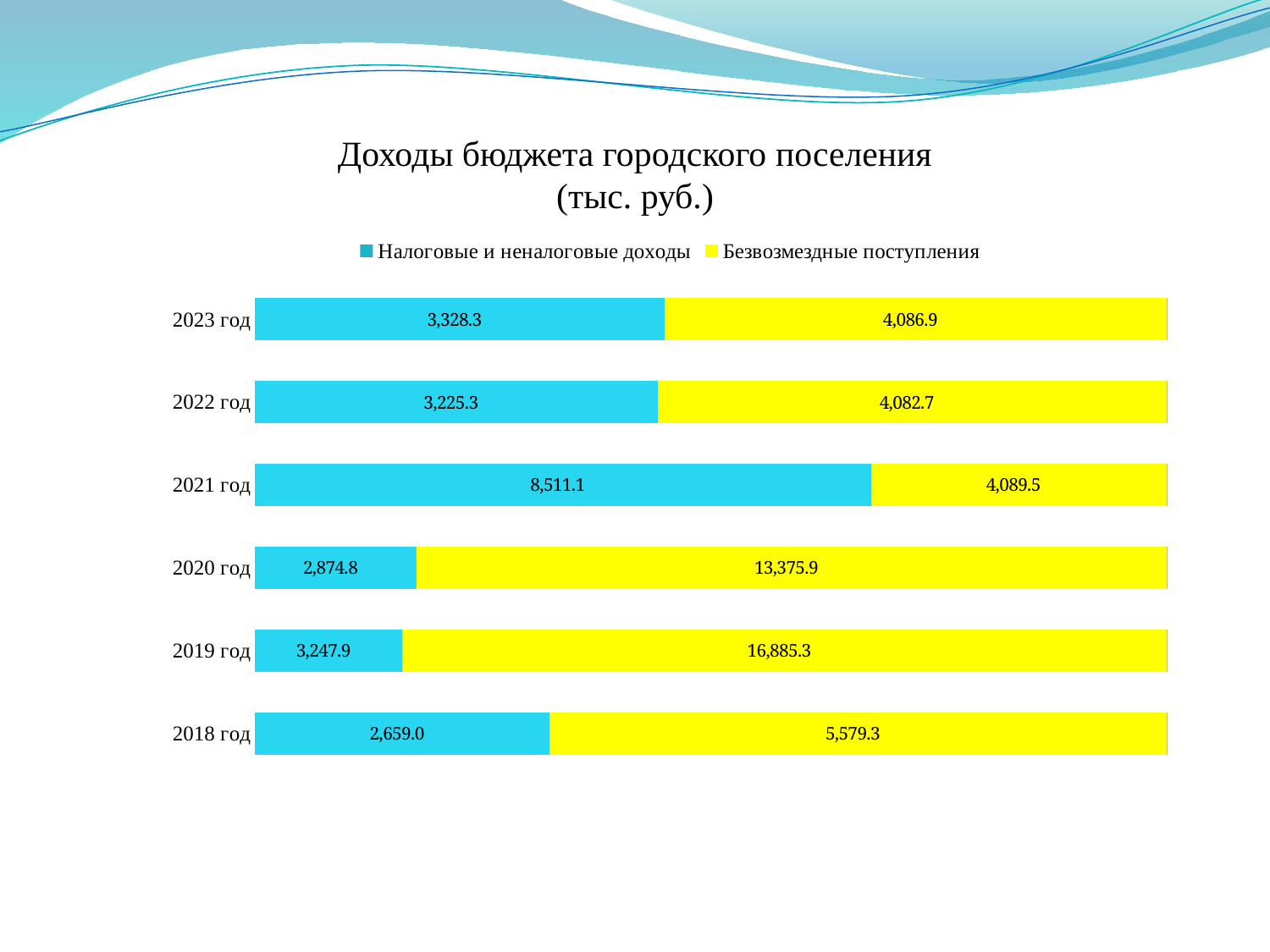
What is the value of Налоговые и неналоговые доходы for 2023 год? 3,328.3 What is the value of Безвозмездные поступления for 2019 год? 16,885.3 What is the value of Налоговые и неналоговые доходы for 2018 год? 2,659.0 How many years are shown in the chart? 6 What is the total of the two series for 2023 год? 7,415.2 How many series does the legend list? 2 Which year has the highest value of Налоговые и неналоговые доходы? 2021 год What is the difference between Налоговые и неналоговые доходы in 2021 год and in 2022 год? 5,285.8 Which year has the lowest value of Налоговые и неналоговые доходы? 2018 год Which year has the highest value of Безвозмездные поступления? 2019 год What kind of chart is shown on the slide? Bar chart Which is larger in 2020 год: Налоговые и неналоговые доходы or Безвозмездные поступления? Безвозмездные поступления